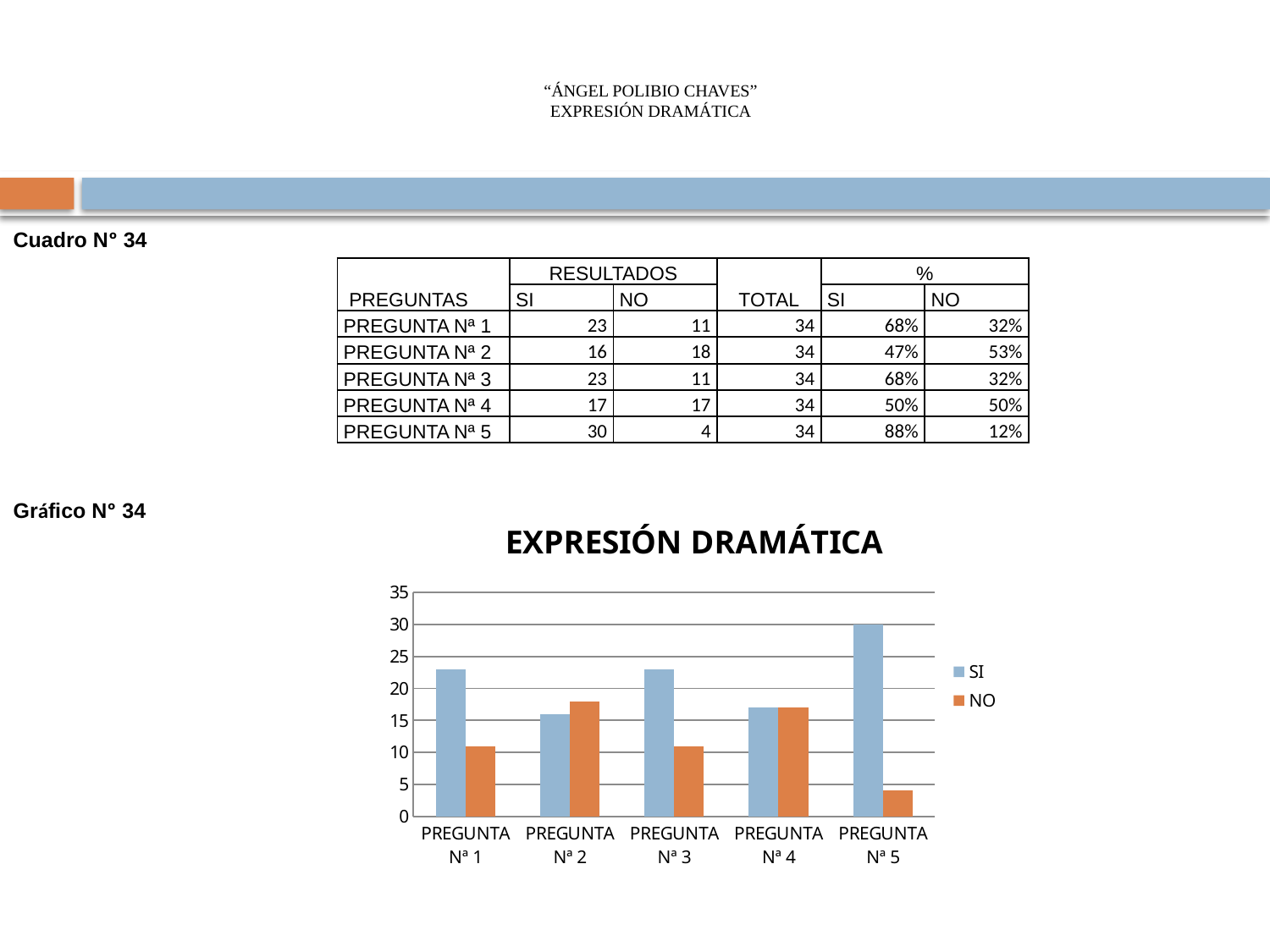
How many series does the legend of the EXPRESIÓN DRAMÁTICA chart list? 2 What kind of chart is shown under Gráfico N° 34? bar chart How many categories (preguntas) are shown on the x axis of the EXPRESIÓN DRAMÁTICA chart? 5 Which pregunta has the highest SI value in the EXPRESIÓN DRAMÁTICA chart? PREGUNTA Nª 5 What is the difference between the SI and NO values for PREGUNTA Nª 5 in the EXPRESIÓN DRAMÁTICA chart? 26 In the EXPRESIÓN DRAMÁTICA chart, is the NO value for PREGUNTA Nª 5 greater or less than 5? less Which pregunta has the lowest NO value in the EXPRESIÓN DRAMÁTICA chart? PREGUNTA Nª 5 In the EXPRESIÓN DRAMÁTICA chart, is the SI value for PREGUNTA Nª 5 greater or less than 25? greater What is the SI value for PREGUNTA Nª 5 in the EXPRESIÓN DRAMÁTICA chart? 30 What is the title of the chart under Gráfico N° 34? EXPRESIÓN DRAMÁTICA In the EXPRESIÓN DRAMÁTICA chart, which is larger for PREGUNTA Nª 2, SI or NO? NO In the EXPRESIÓN DRAMÁTICA chart, which is larger for PREGUNTA Nª 1, SI or NO? SI